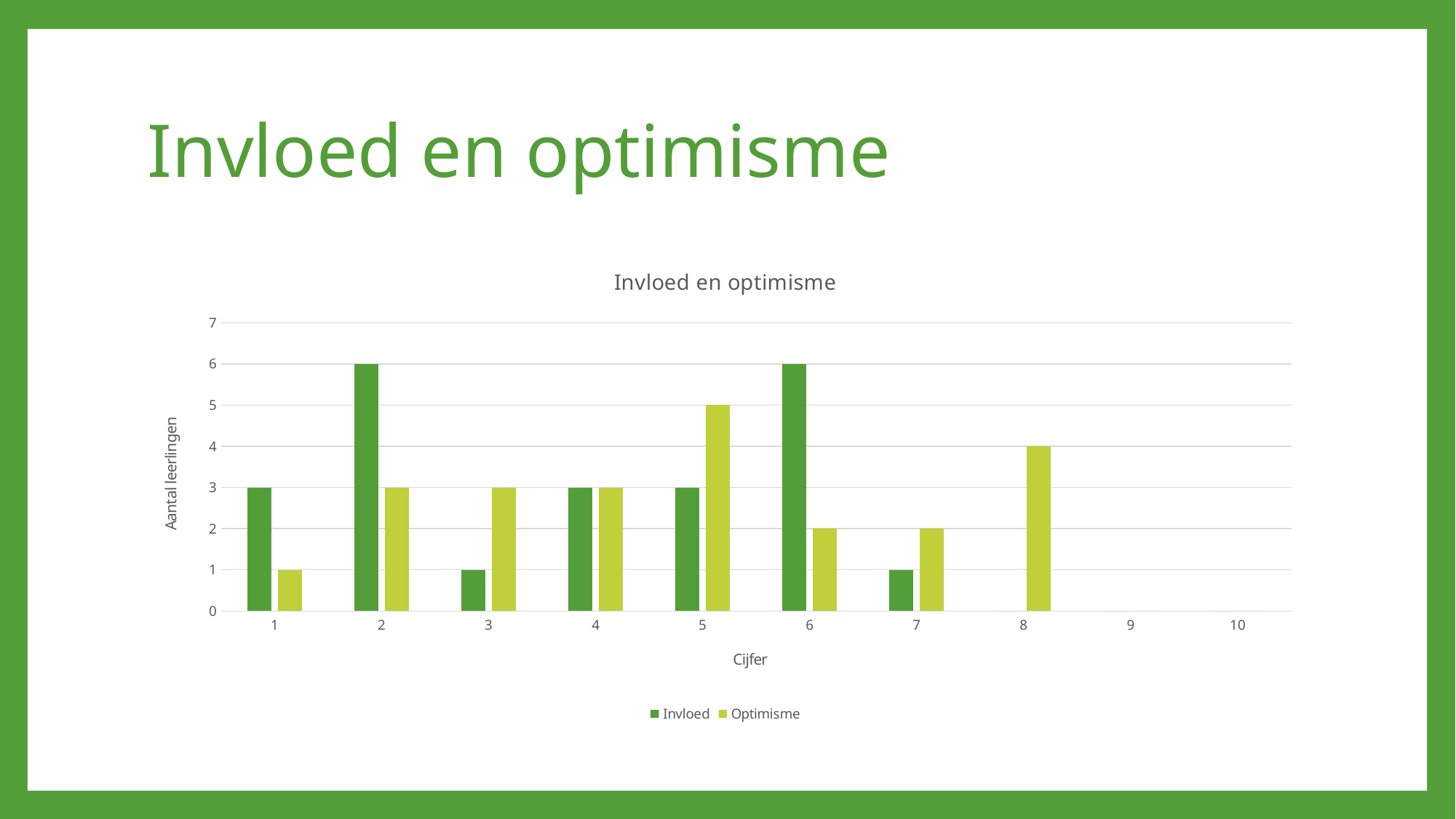
What is the label of the x axis? Cijfer What is the Optimisme value for Cijfer 8? 4 What is the difference between the Invloed and Optimisme values for Cijfer 1? 2 Which is larger for Cijfer 6, the Invloed value or the Optimisme value? Invloed How many categories are shown on the x axis? 10 For which Cijfer is the Optimisme value highest? 5 Is the Invloed value for Cijfer 2 greater or less than 5? greater How many series does the legend list? 2 What is the Invloed value for Cijfer 2? 6 What kind of chart is shown on the slide? bar chart What are the two series named in the legend? Invloed and Optimisme What is the Optimisme value for Cijfer 5? 5